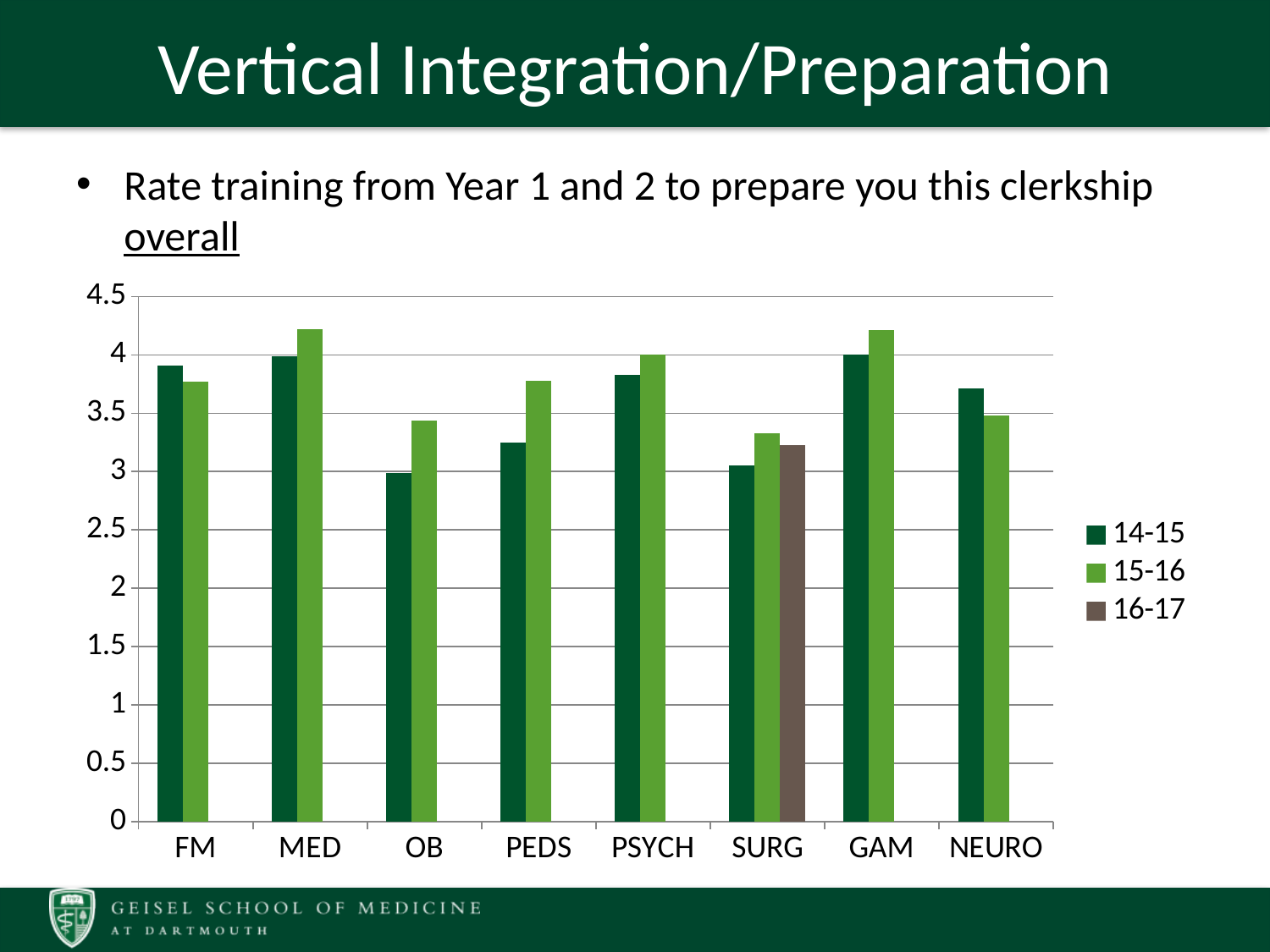
Is the 14-15 value for PEDS greater or less than 3.5? less What kind of chart is shown on the slide? bar chart Is the 16-17 value for SURG greater or less than 3? greater How many clerkship categories are shown on the x axis? 8 Is the 15-16 value for MED greater or less than 4? greater For OB, which series has the larger value, 14-15 or 15-16? 15-16 Which category is the only one with a 16-17 bar? SURG How many series does the legend list? 3 For NEURO, which series has the larger value, 14-15 or 15-16? 14-15 For PEDS, which series has the larger value, 14-15 or 15-16? 15-16